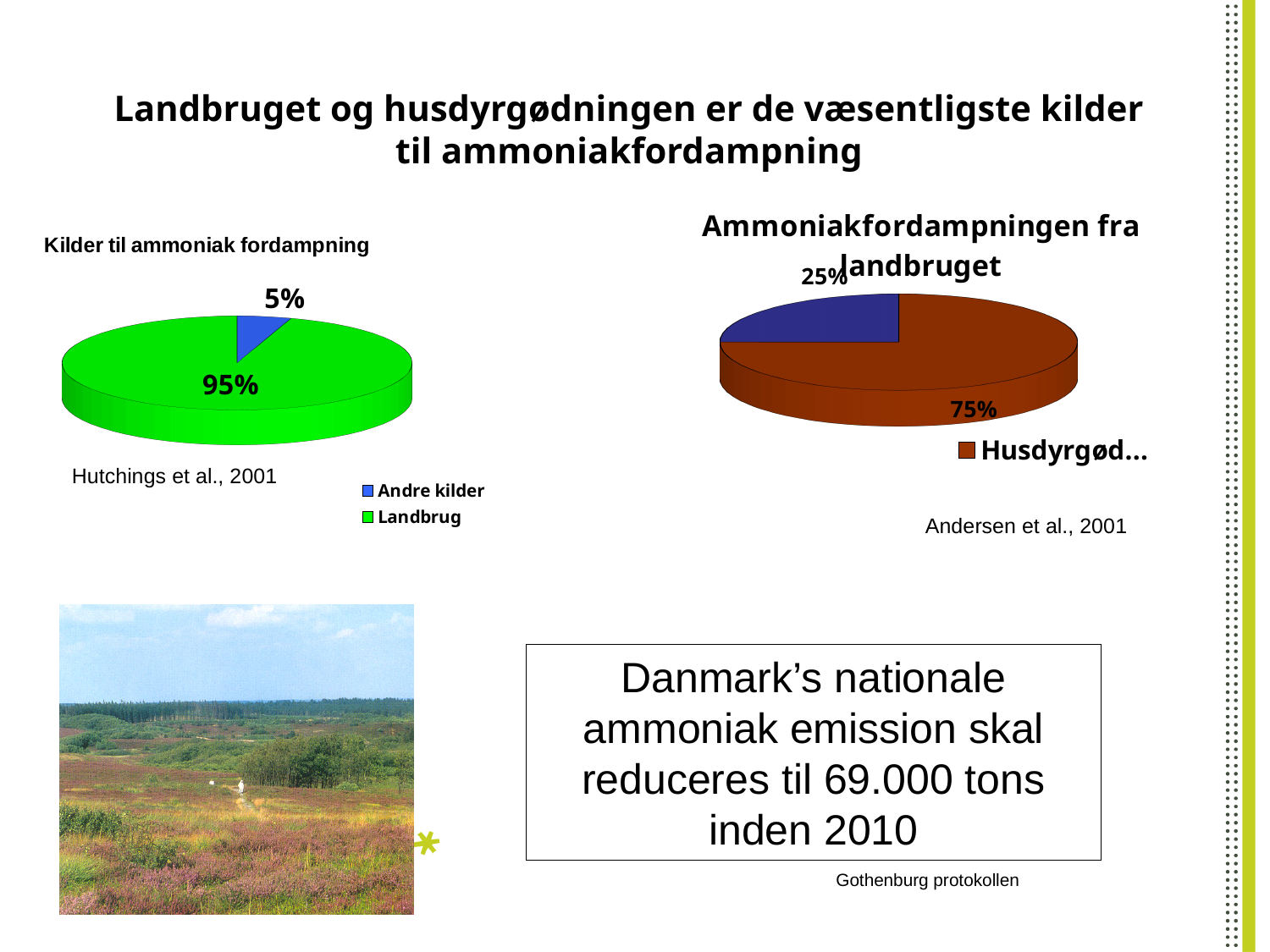
In the chart titled "Kilder til ammoniak fordampning", which category has the smallest slice? Andre kilder In the chart titled "Kilder til ammoniak fordampning", how many categories does the legend list? 2 In the chart titled "Kilder til ammoniak fordampning", which category has the largest slice? Landbrug What type of chart is the chart titled "Kilder til ammoniak fordampning"? Pie chart In the chart titled "Ammoniakfordampningen fra landbruget", what is the value of the largest slice? 75% In the chart titled "Kilder til ammoniak fordampning", what is the difference in percentage points between Landbrug and Andre kilder? 90 percentage points In the chart titled "Kilder til ammoniak fordampning", what share does Landbrug have? 95% In the chart titled "Kilder til ammoniak fordampning", what colour is the Landbrug slice? Green In the chart titled "Ammoniakfordampningen fra landbruget", how many slices does the pie have? 2 In the chart titled "Ammoniakfordampningen fra landbruget", what is the value of the smallest slice? 25% What type of chart is the chart titled "Ammoniakfordampningen fra landbruget"? Pie chart In the chart titled "Kilder til ammoniak fordampning", what share does Andre kilder have? 5%